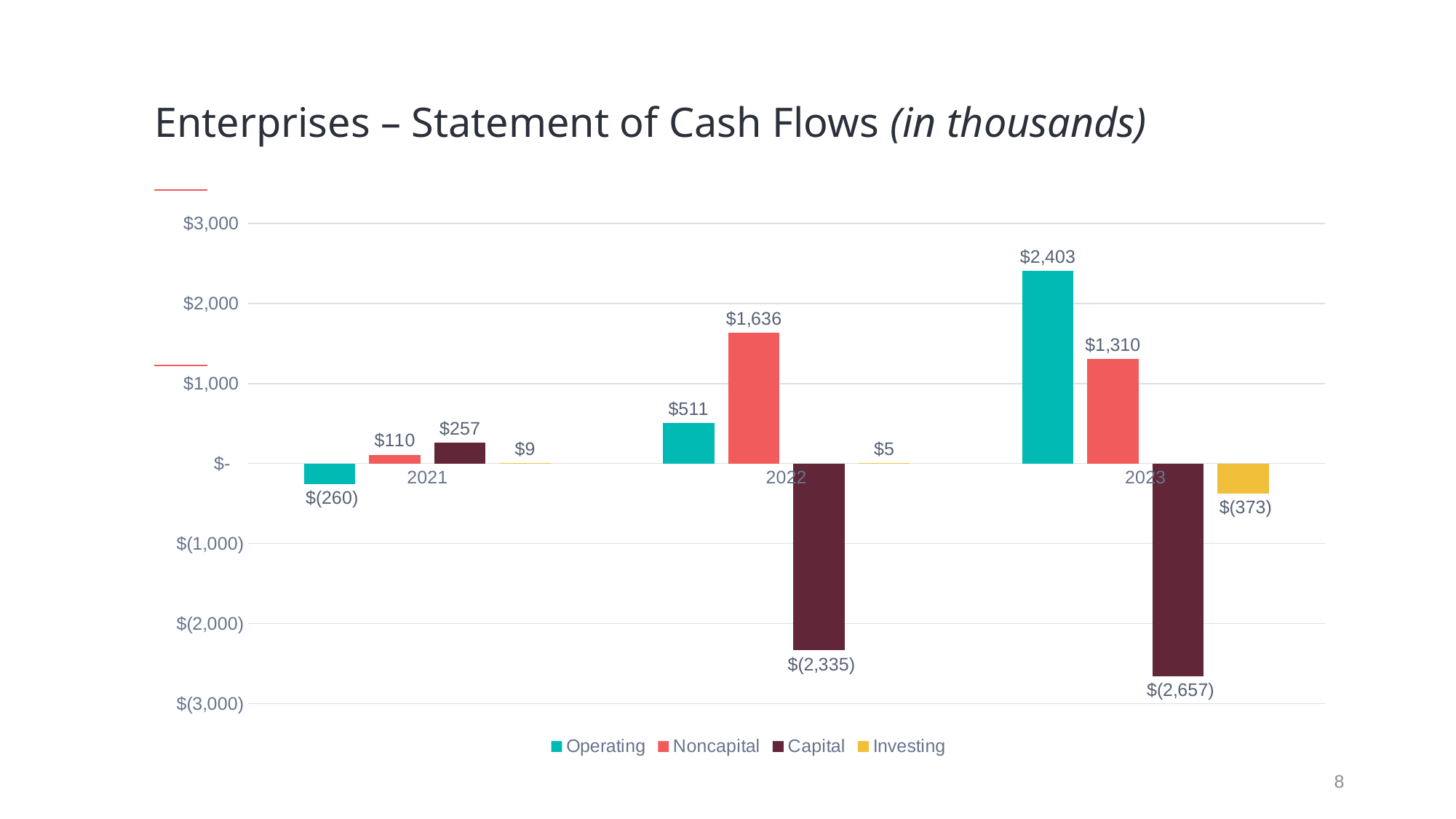
What is the Noncapital value for 2022? $1,636 Which is larger, the Operating value for 2022 or the Noncapital value for 2022? Noncapital value for 2022 What is the Capital value for 2022? $(2,335) What is the Operating cash flow value for 2023? $2,403 What is the Investing value for 2021? $9 What kind of chart is shown on the slide? Bar chart How many years are shown on the x axis? 3 In which year is the Operating value highest? 2023 What is the difference between the Noncapital values for 2022 and 2023? $326 Does the Operating value rise or fall from 2021 to 2023? Rise In which year is the Capital value lowest? 2023 How many series does the legend list? 4